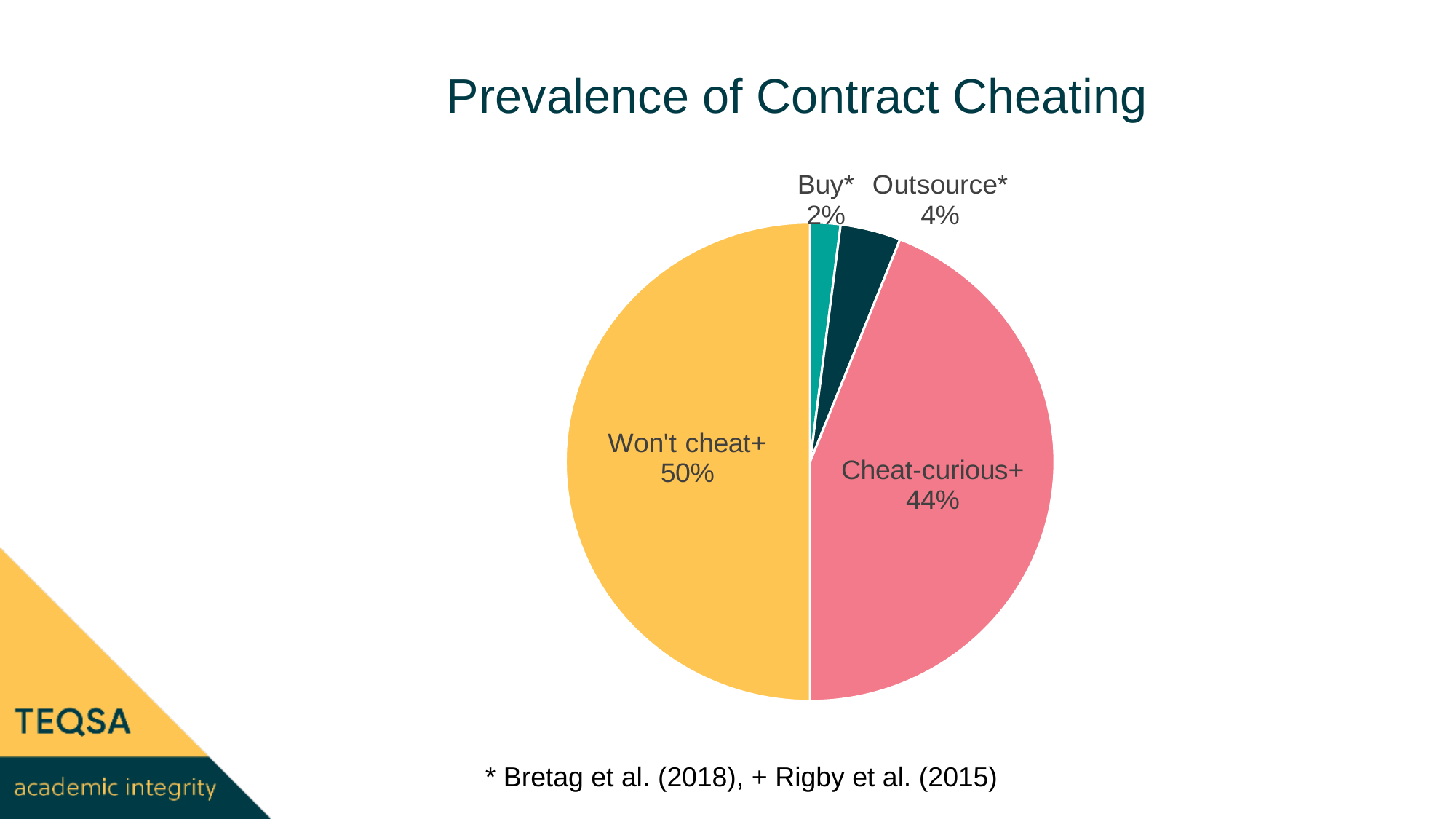
Which slice of the pie is the smallest? Buy* What is the title of the chart? Prevalence of Contract Cheating Which slice of the pie is the largest? Won't cheat+ What is the difference between the "Won't cheat+" and "Cheat-curious+" slices? 6% What percentage of the pie is labelled "Buy*"? 2% What percentage of the pie is labelled "Won't cheat+"? 50% Which is larger, the "Outsource*" slice or the "Buy*" slice? Outsource* What kind of chart is shown on the slide? pie chart What colour is the "Cheat-curious+" slice? pink How many slices does the pie chart have? 4 What percentage of the pie is labelled "Cheat-curious+"? 44% What percentage of the pie is labelled "Outsource*"? 4%